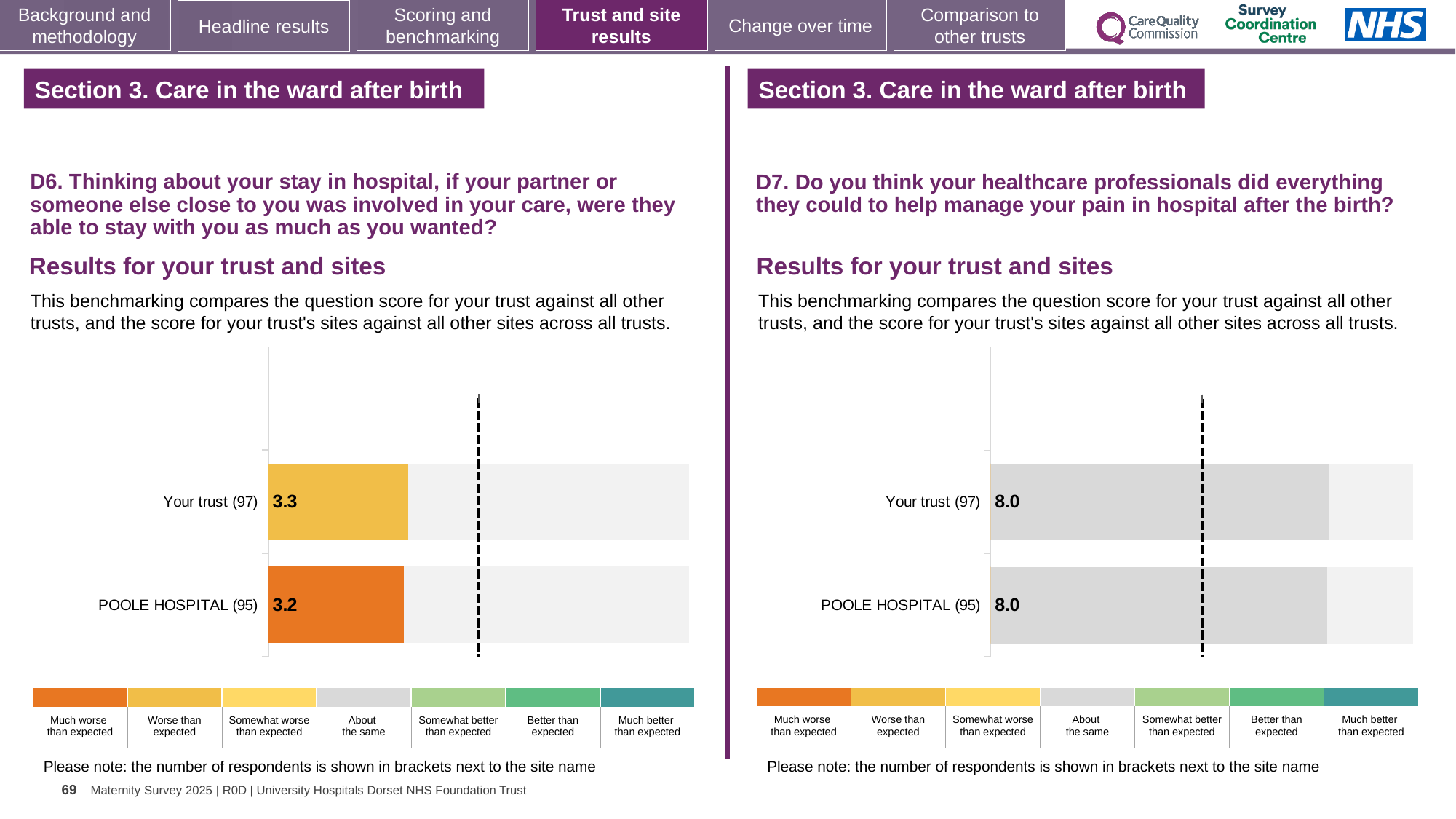
In the D7 chart on the right, what is the score for Your trust? 8.0 In the D6 chart on the left, what is the score for POOLE HOSPITAL? 3.2 In the D6 chart on the left, which has the higher score, Your trust or POOLE HOSPITAL? Your trust How many respondents are shown in brackets for POOLE HOSPITAL in the D6 chart on the left? 95 In the D6 chart on the left, what is the difference between the scores for Your trust and POOLE HOSPITAL? 0.1 In the D7 chart on the right, which benchmark category does the grey colour of the bars correspond to in the legend? About the same What type of chart is used for the D7 results on the right? Bar chart In the D7 chart on the right, what is the difference between the scores for Your trust and POOLE HOSPITAL? 0.0 In the D7 chart on the right, what is the score for POOLE HOSPITAL? 8.0 In the D6 chart on the left, what is the score for Your trust? 3.3 In the D6 chart on the left, which benchmark category does the colour of the POOLE HOSPITAL bar correspond to in the legend? Much worse than expected How many bars are plotted in the D6 chart on the left? 2